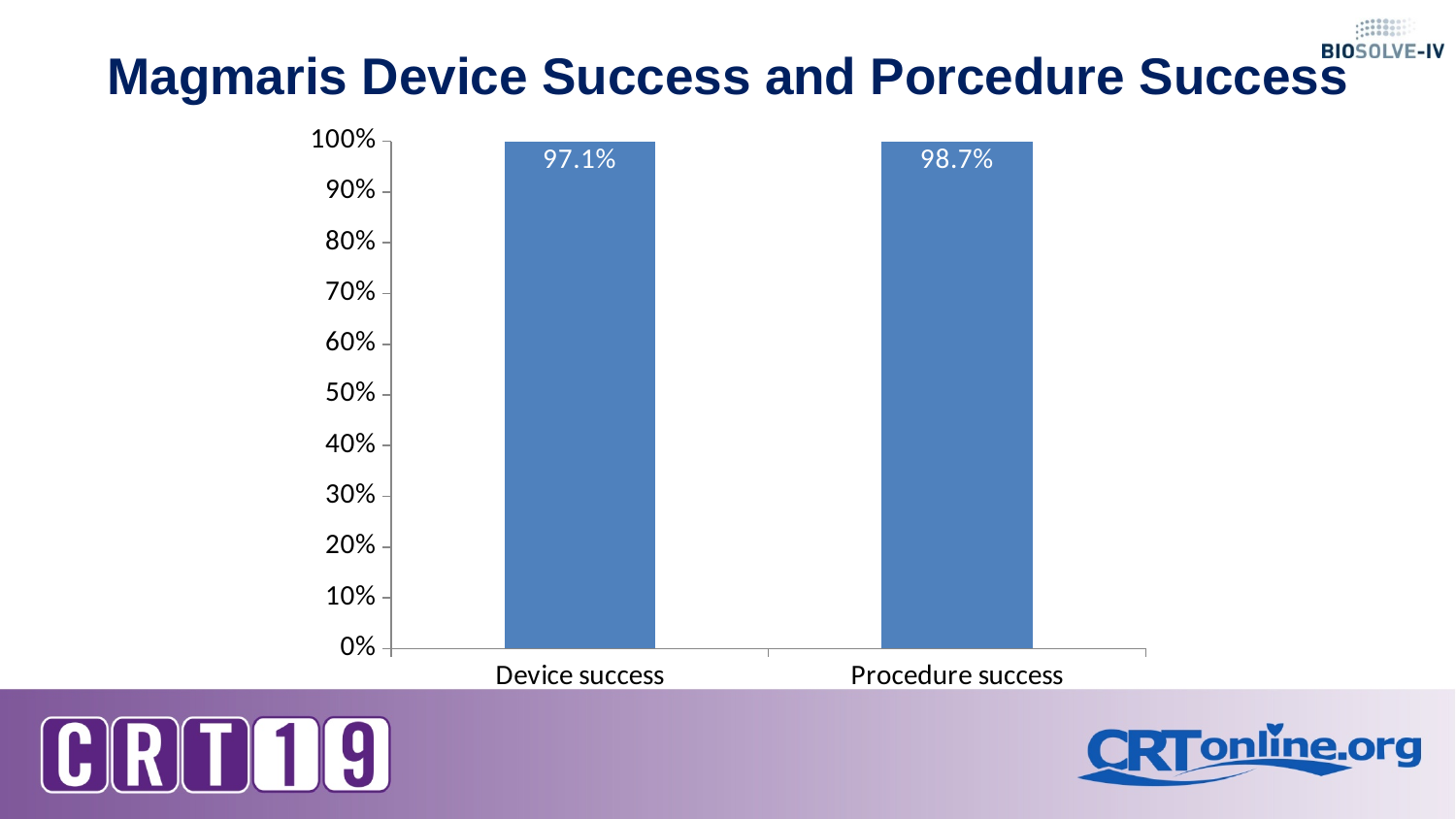
Which category has the lower value? Device success What is the maximum value shown on the y axis? 100% What is the title of the slide? Magmaris Device Success and Porcedure Success Which category has the higher value? Procedure success What kind of chart is shown on the slide? Bar chart How many categories are shown on the chart? 2 What is the value for Procedure success? 98.7% What is the value for Device success? 97.1% Is the value for Device success greater or less than 90%? greater What is the difference between Procedure success and Device success? 1.6%